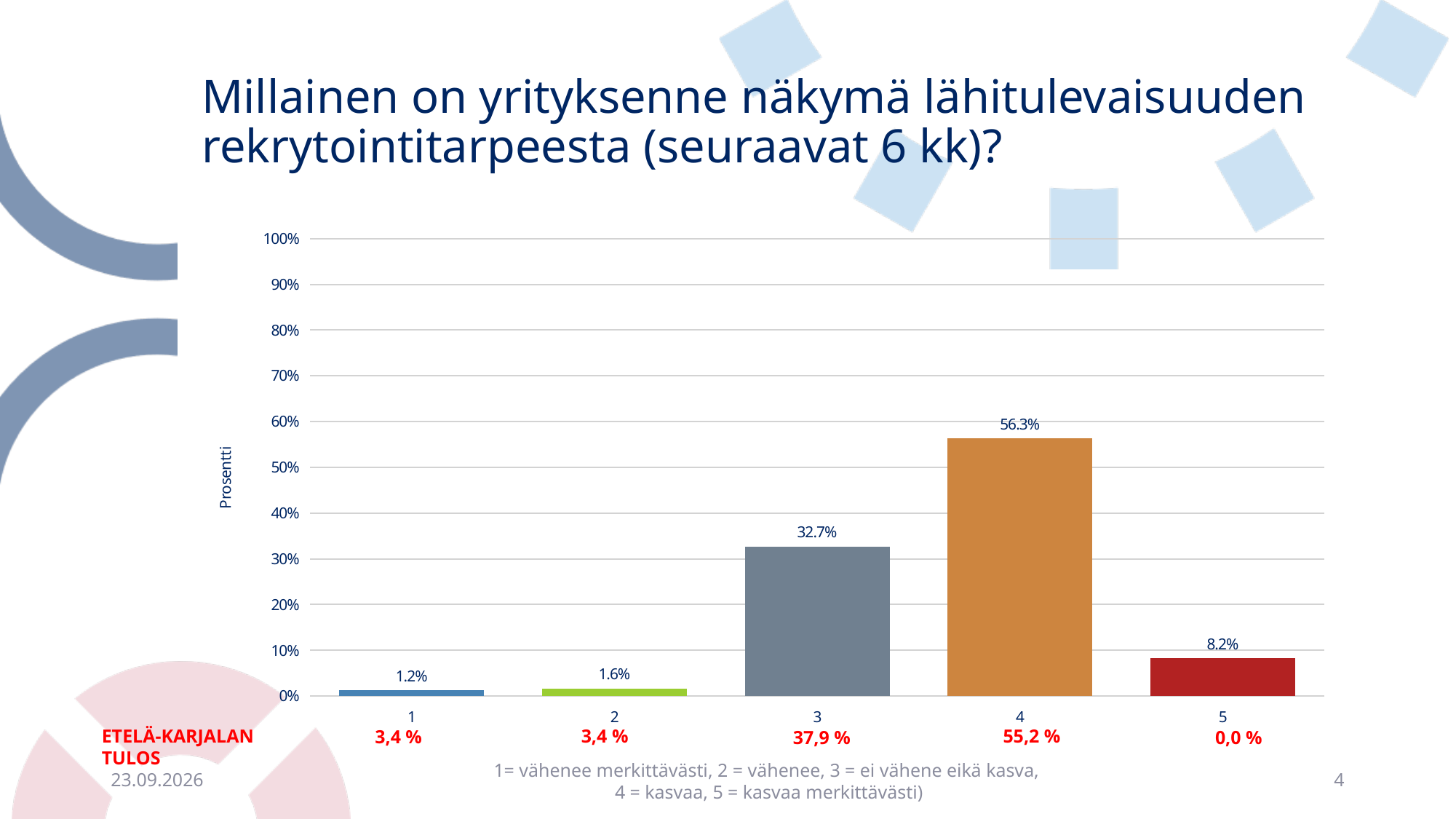
Which has the larger value, category 3 or category 5? 3 Which category has the highest value in the chart? 4 What is the difference between the values for category 4 and category 3? 23.6% What is the label of the vertical axis of the chart? Prosentti What is the difference between the values for category 5 and category 2? 6.6% What is the value for category 5 in the chart? 8.2% What type of chart is shown on the slide? bar chart How many categories are shown on the x axis of the chart? 5 What is the value for category 1 in the chart? 1.2% Is the value for category 4 greater or less than 50%? greater What is the value for category 4 in the chart? 56.3% What is the value for category 3 in the chart? 32.7%